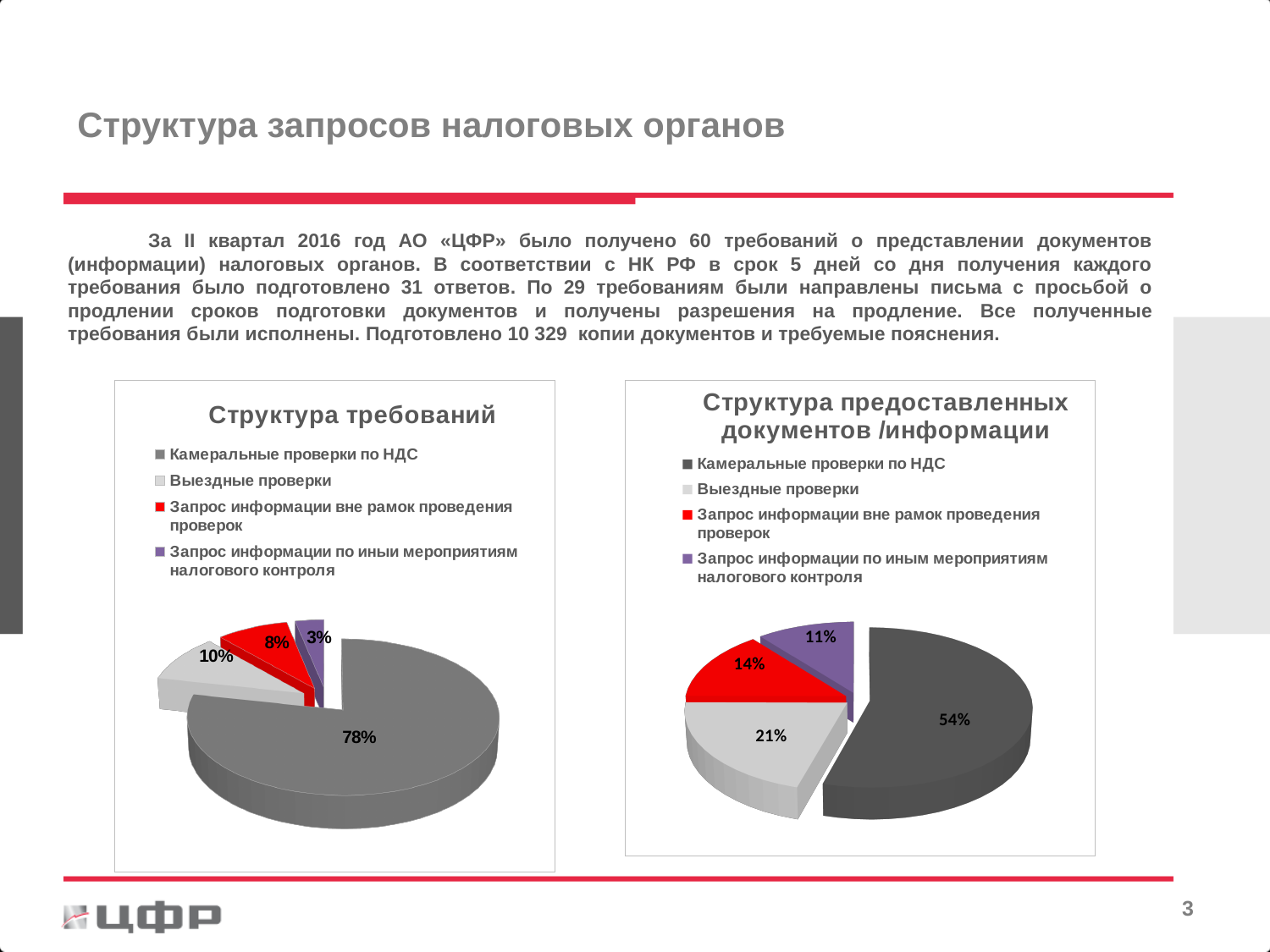
How many categories does the legend of the chart titled "Структура предоставленных документов /информации" list? 4 In the chart titled "Структура требований", which category has the smallest slice? Запрос информации по иныи мероприятиям налогового контроля In the chart titled "Структура требований", what is the value for "Запрос информации вне рамок проведения проверок"? 8% In the chart titled "Структура требований", what is the value for "Выездные проверки"? 10% In the chart titled "Структура предоставленных документов /информации", what is the difference between the shares of "Выездные проверки" and "Запрос информации вне рамок проведения проверок"? 7% In the chart titled "Структура предоставленных документов /информации", what is the value for "Выездные проверки"? 21% In the chart titled "Структура предоставленных документов /информации", what share does "Камеральные проверки по НДС" have? 54% In the chart titled "Структура требований", which is larger: the share of "Выездные проверки" or the share of "Запрос информации вне рамок проведения проверок"? Выездные проверки In the chart titled "Структура предоставленных документов /информации", what is the value for "Запрос информации по иным мероприятиям налогового контроля"? 11% In the chart titled "Структура предоставленных документов /информации", which category has the largest slice? Камеральные проверки по НДС In the chart titled "Структура требований", what share does "Камеральные проверки по НДС" have? 78% What type of chart is the chart titled "Структура требований"? Pie chart